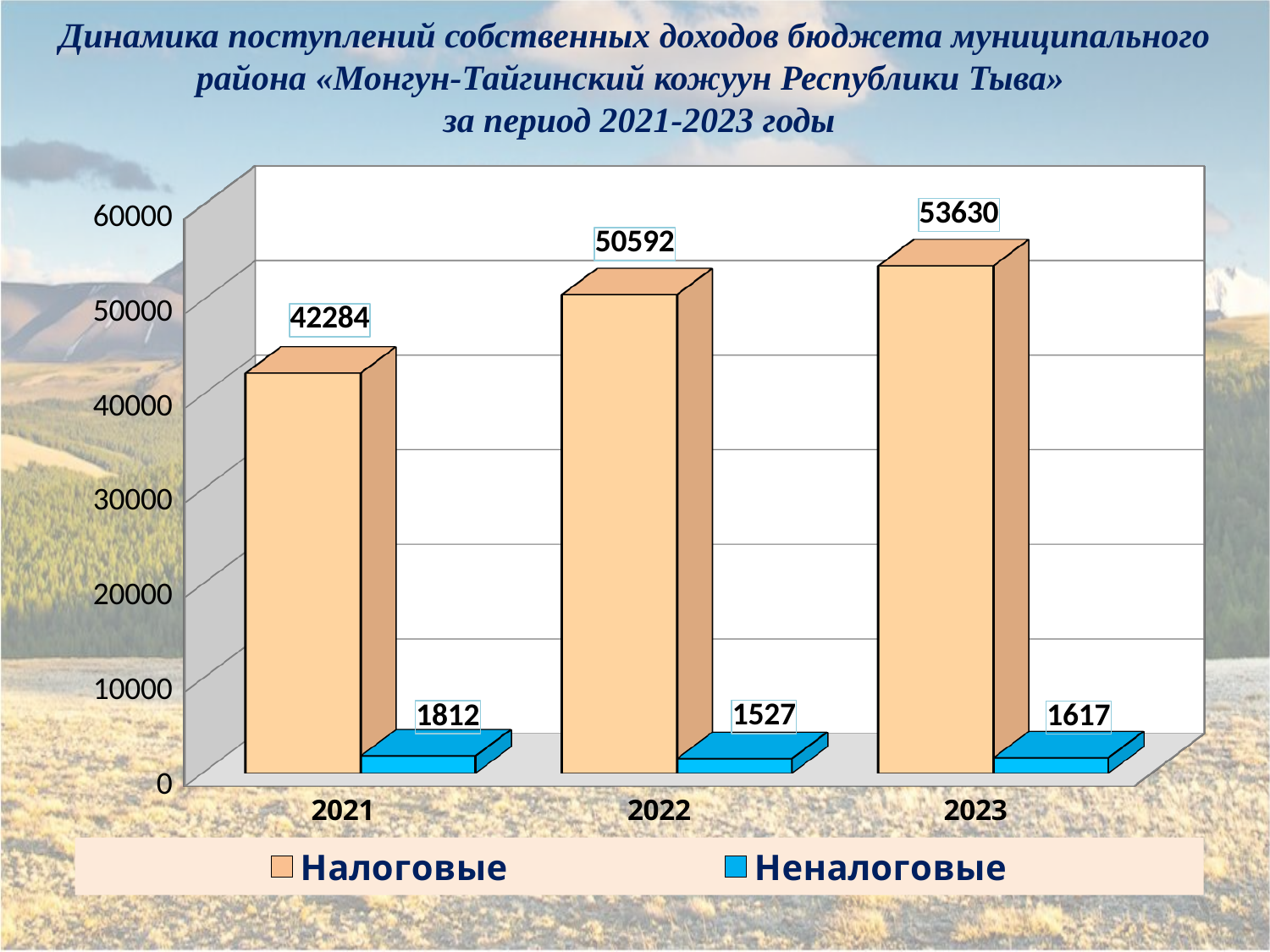
Do the Налоговые values rise or fall from 2021 to 2023? rise What is the value of Неналоговые for 2022? 1527 What is the difference between the Налоговые values for 2023 and 2022? 3038 What kind of chart is shown on the slide? bar chart Which year has the highest Налоговые value? 2023 Which year has the lowest Неналоговые value? 2022 How many years are shown on the x axis? 3 What is the value of Налоговые for 2021? 42284 Which is larger, Неналоговые in 2021 or Неналоговые in 2023? 2021 What is the value of Налоговые for 2023? 53630 How many series does the legend list? 2 Is the Налоговые value for 2022 greater or less than 50000? greater